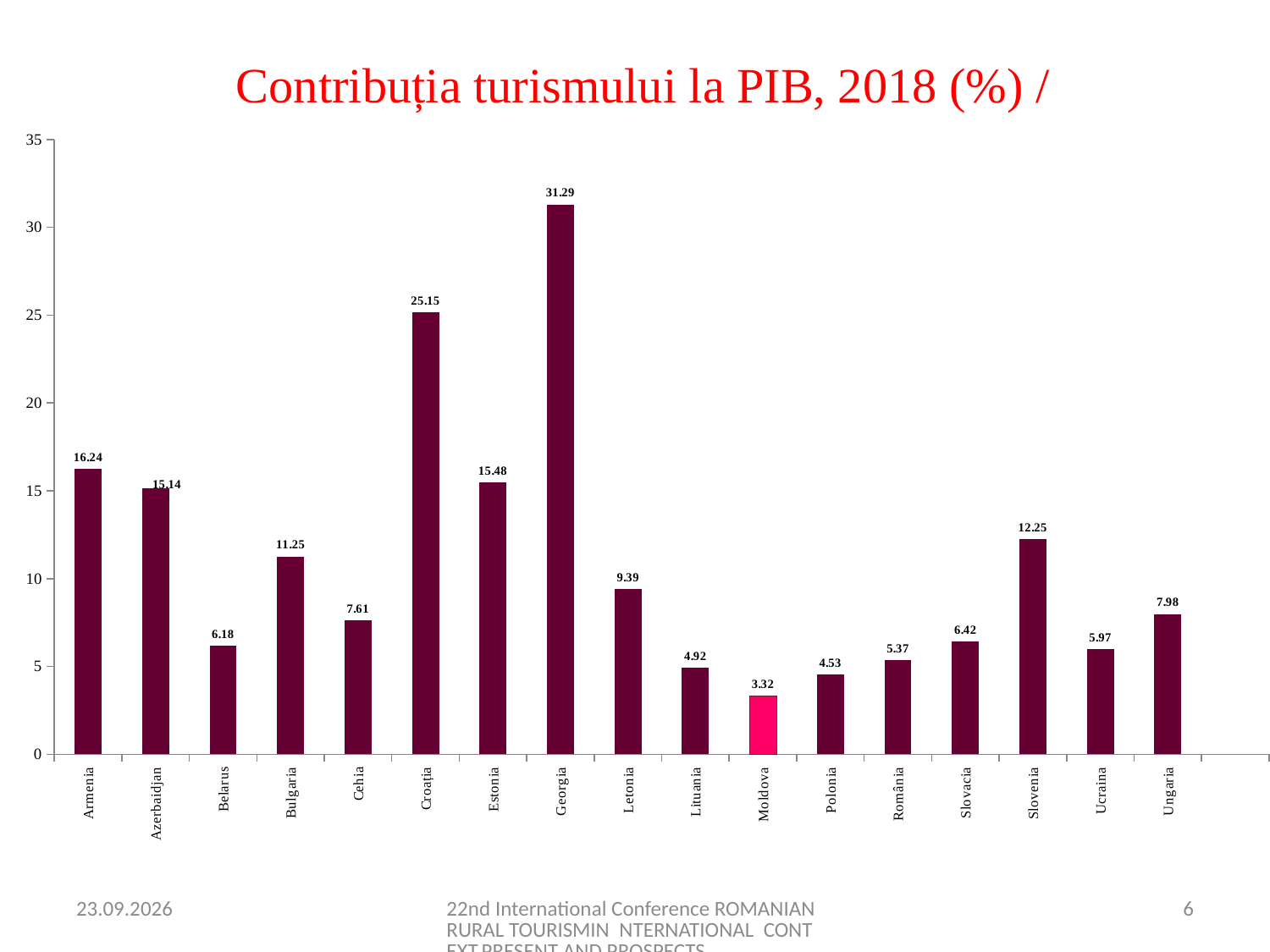
Which country has the highest value? Georgia What is the difference between the values for Armenia and Moldova? 12.92 How many countries are shown on the chart? 17 What is the difference between the values for Georgia and Croația? 6.14 Which is larger, the value for Estonia or the value for Slovenia? Estonia What is the value for Georgia? 31.29 Which country's bar is coloured differently (pink) from the others? Moldova What is the value for Moldova? 3.32 What kind of chart is shown on the slide? bar chart What is the value for România? 5.37 Which country has the lowest value? Moldova Is the value for Bulgaria greater or less than 10? greater